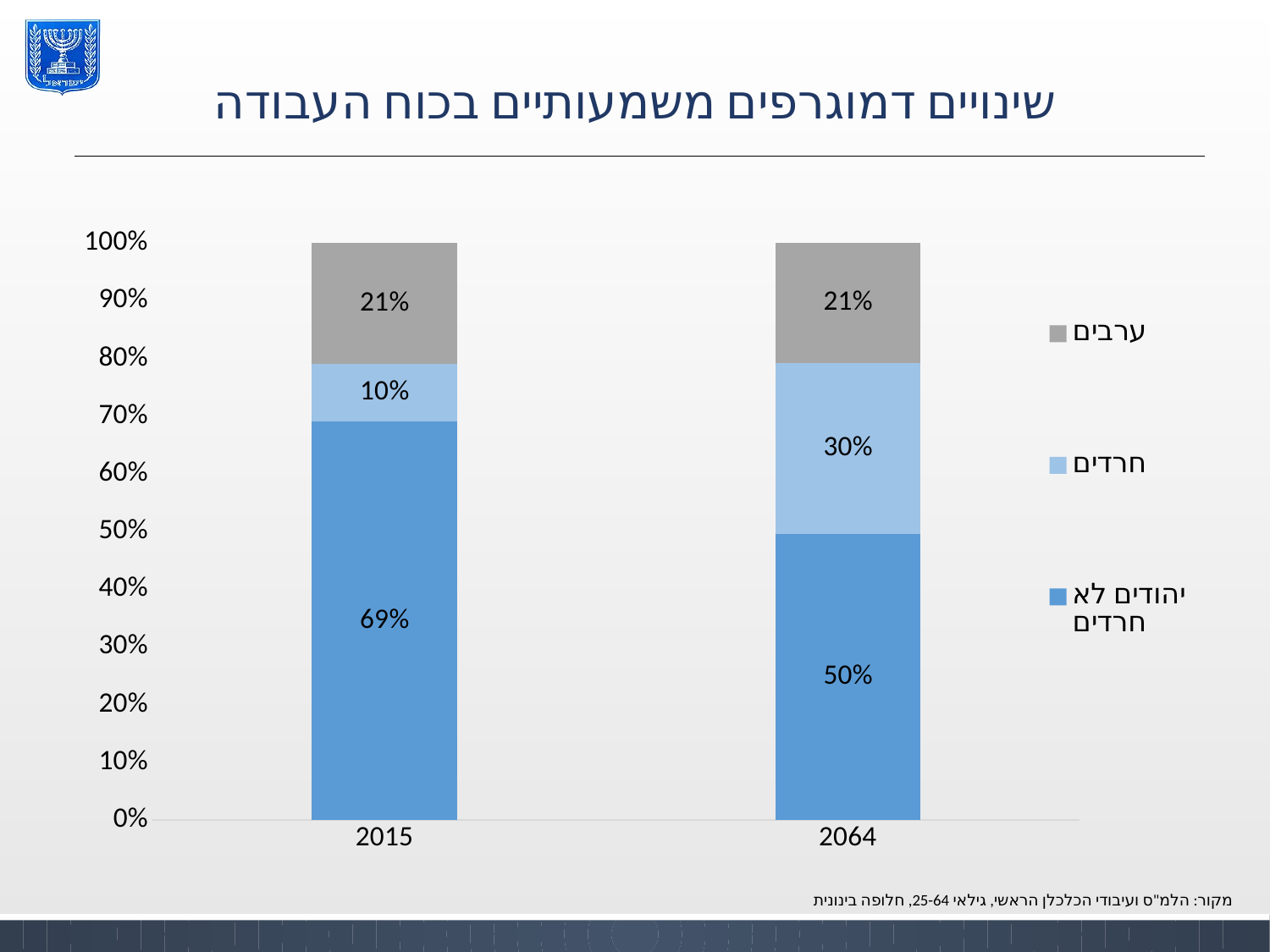
How many series does the legend list? 3 Which series has the smallest share in the 2015 bar? חרדים What kind of chart is shown on the slide? Stacked bar chart Which series has the largest share in the 2064 bar? יהודים לא חרדים By how many percentage points does the share of חרדים change from 2015 to 2064? 20% What is the value for יהודים לא חרדים in 2064? 50% What is the value for חרדים in 2064? 30% What is the title of the chart on the slide? שינויים דמוגרפיים משמעותיים בכוח העבודה How many categories are shown on the x axis? 2 Which is larger: the share of יהודים לא חרדים in 2015 or in 2064? 2015 What is the value for יהודים לא חרדים in 2015? 69% What is the value for ערבים in 2015? 21%